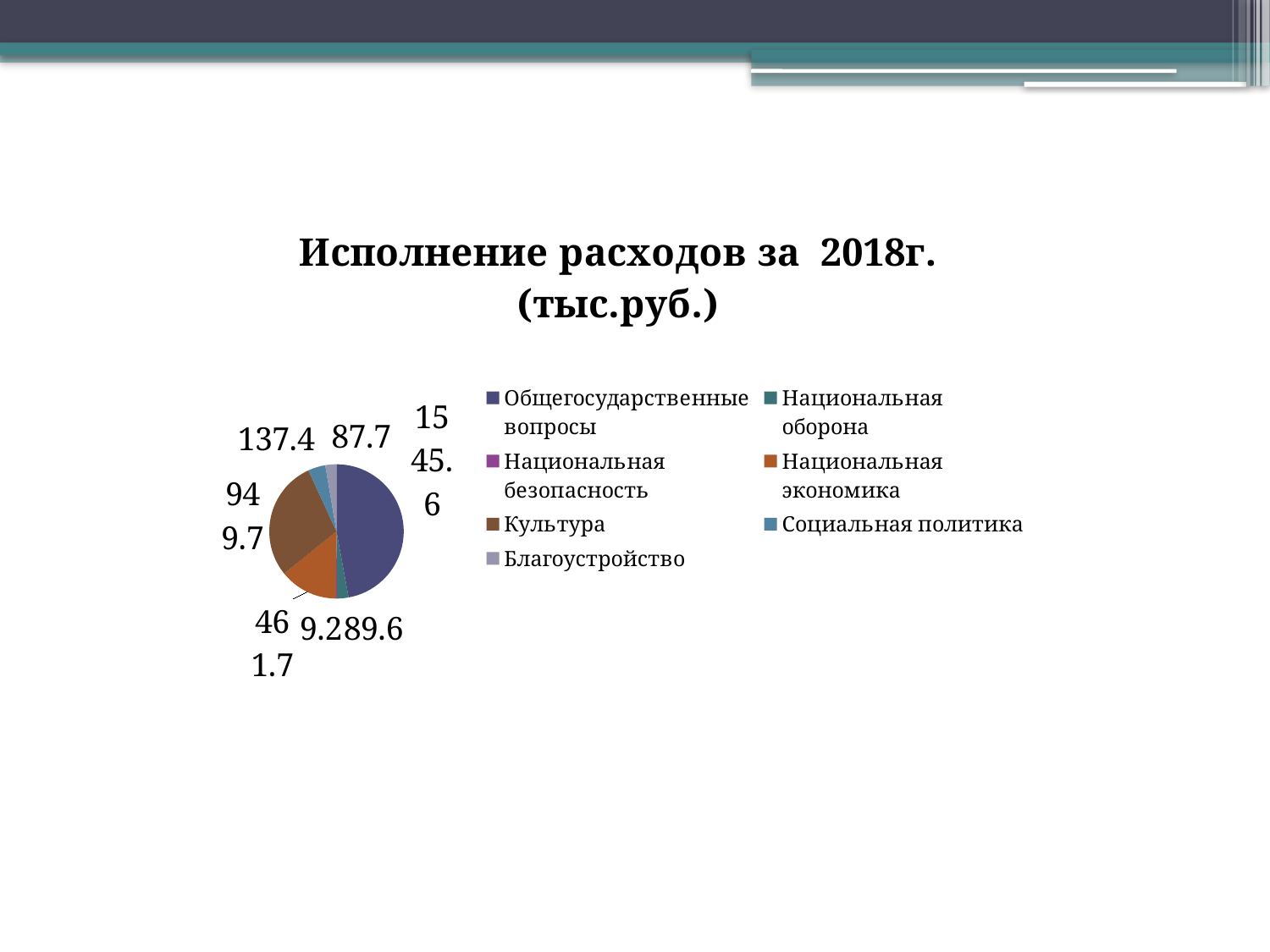
Which is larger, Культура or Национальная экономика? Культура What is the value for Общегосударственные вопросы? 1545.6 What is the value for Социальная политика? 137.4 How many categories does the legend of the pie chart list? 7 What is the title of the chart? Исполнение расходов за 2018г. (тыс.руб.) What is the value for Культура? 949.7 What kind of chart is shown on the slide? pie chart What is the value for Национальная экономика? 461.7 What is the difference between the values for Общегосударственные вопросы and Культура? 595.9 What is the difference between the values for Культура and Национальная экономика? 488 Which category has the largest slice of the pie? Общегосударственные вопросы What is the value for Благоустройство? 87.7